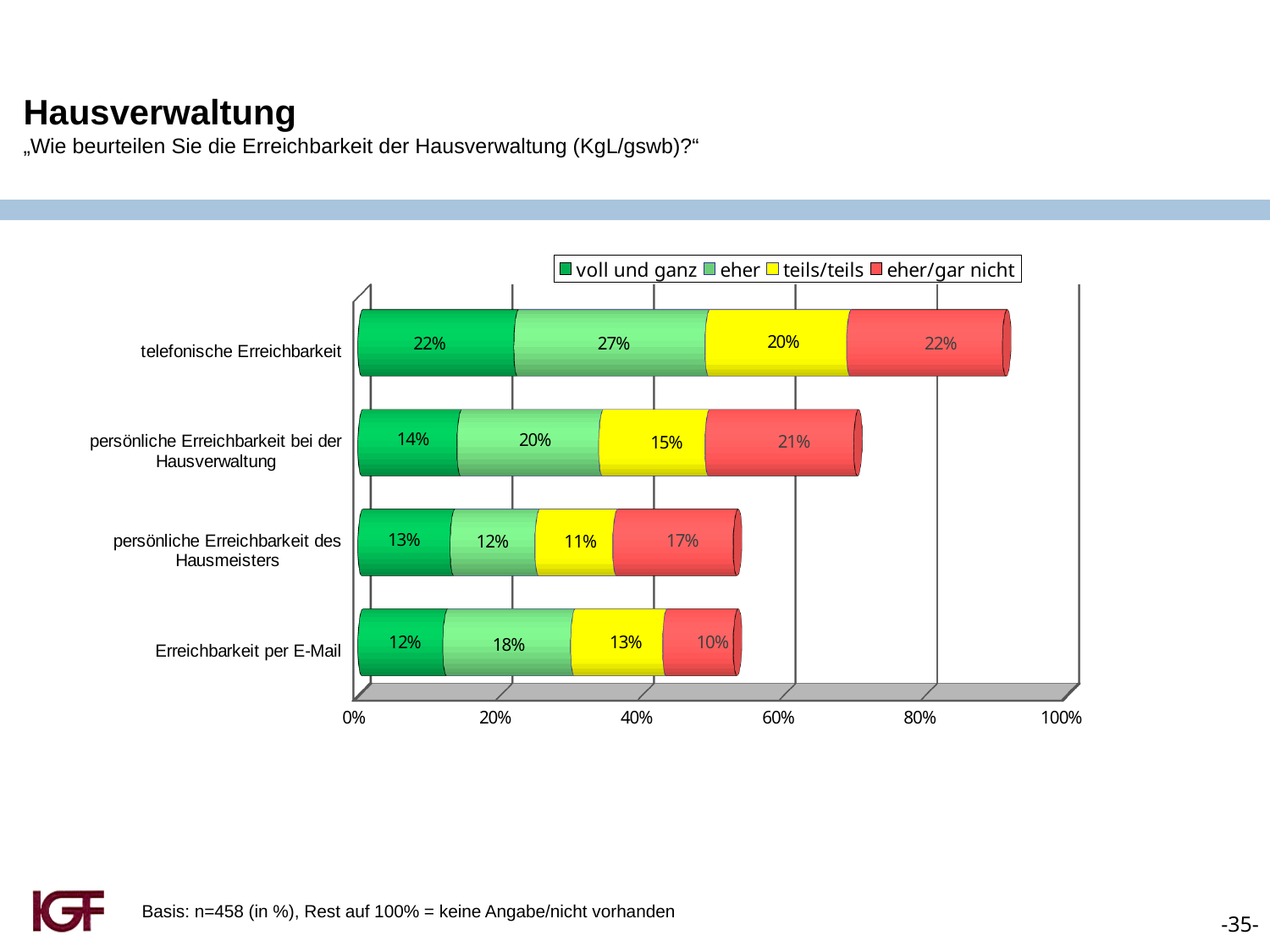
How many categories are shown on the chart? 4 What is the 'voll und ganz' value for 'telefonische Erreichbarkeit'? 22% How many series does the legend list? 4 Which category has the highest 'voll und ganz' value? telefonische Erreichbarkeit What is the difference between the 'eher' values for 'telefonische Erreichbarkeit' and 'Erreichbarkeit per E-Mail'? 9% Which category has the lowest 'eher/gar nicht' value? Erreichbarkeit per E-Mail What is the 'eher/gar nicht' value for 'persönliche Erreichbarkeit bei der Hausverwaltung'? 21% What is the 'eher' value for 'persönliche Erreichbarkeit des Hausmeisters'? 12% What is the 'teils/teils' value for 'Erreichbarkeit per E-Mail'? 13% What kind of chart is shown on the slide? stacked bar chart Which is larger: the 'eher/gar nicht' value for 'telefonische Erreichbarkeit' or for 'persönliche Erreichbarkeit des Hausmeisters'? telefonische Erreichbarkeit What is the total of the stacked bar for 'persönliche Erreichbarkeit bei der Hausverwaltung'? 70%